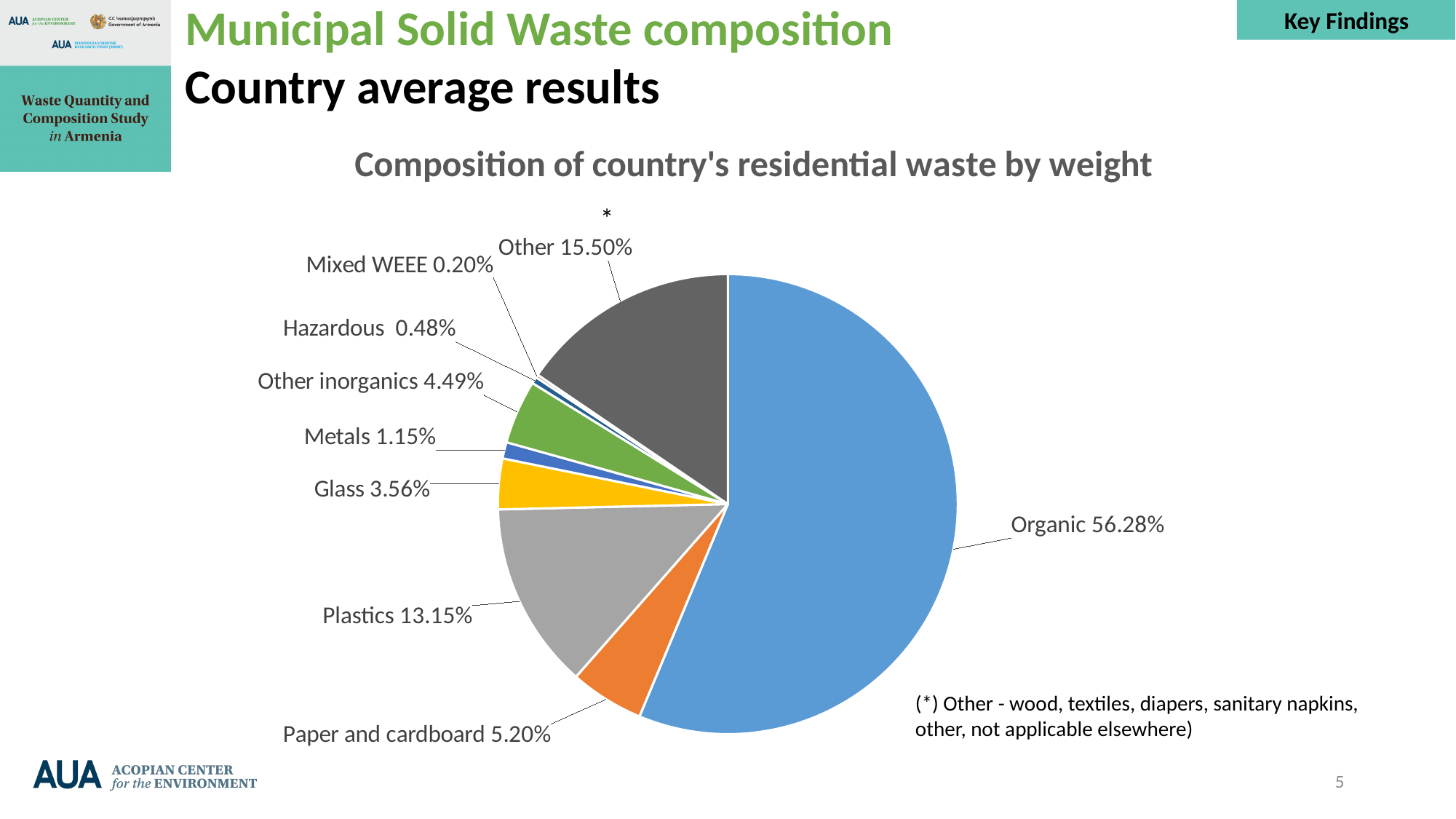
Which is larger, the share for Other inorganics or the share for Glass? Other inorganics What is the title of the chart? Composition of country's residential waste by weight How many categories are shown in the pie chart? 9 What share of the country's residential waste by weight is Organic? 56.28% What percentage does the Glass slice represent? 3.56% What percentage of the residential waste is Plastics? 13.15% What is the share for Paper and cardboard? 5.20% Which category has the largest share of the residential waste? Organic How many percentage points larger is the Other share than the Plastics share? 2.35 What colour is the Organic slice of the pie chart? Blue What type of chart is shown on the slide? Pie chart Which category has the smallest share of the residential waste? Mixed WEEE